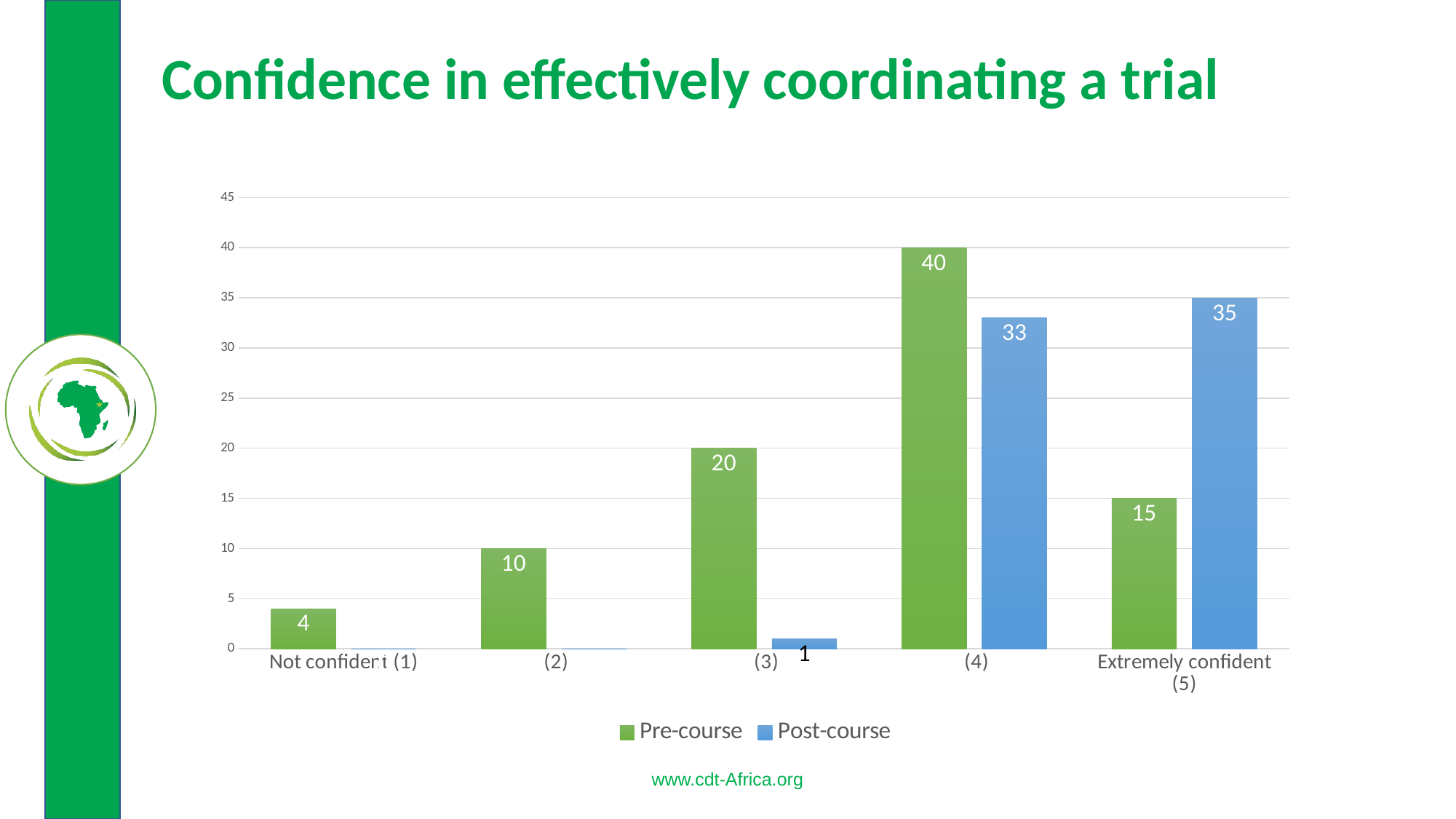
What is the Pre-course value for category (4)? 40 What is the Post-course value for Extremely confident (5)? 35 How many series does the legend list? 2 What is the title of the slide? Confidence in effectively coordinating a trial What is the Pre-course value for Not confident (1)? 4 Which category has the highest Pre-course value? (4) Which category has the lowest Pre-course value? Not confident (1) For Extremely confident (5), which is larger: the Pre-course or the Post-course value? Post-course What kind of chart is shown on the slide? Bar chart What is the difference between the Pre-course and Post-course values for category (4)? 7 What is the Post-course value for category (3)? 1 How many categories are shown on the x axis? 5